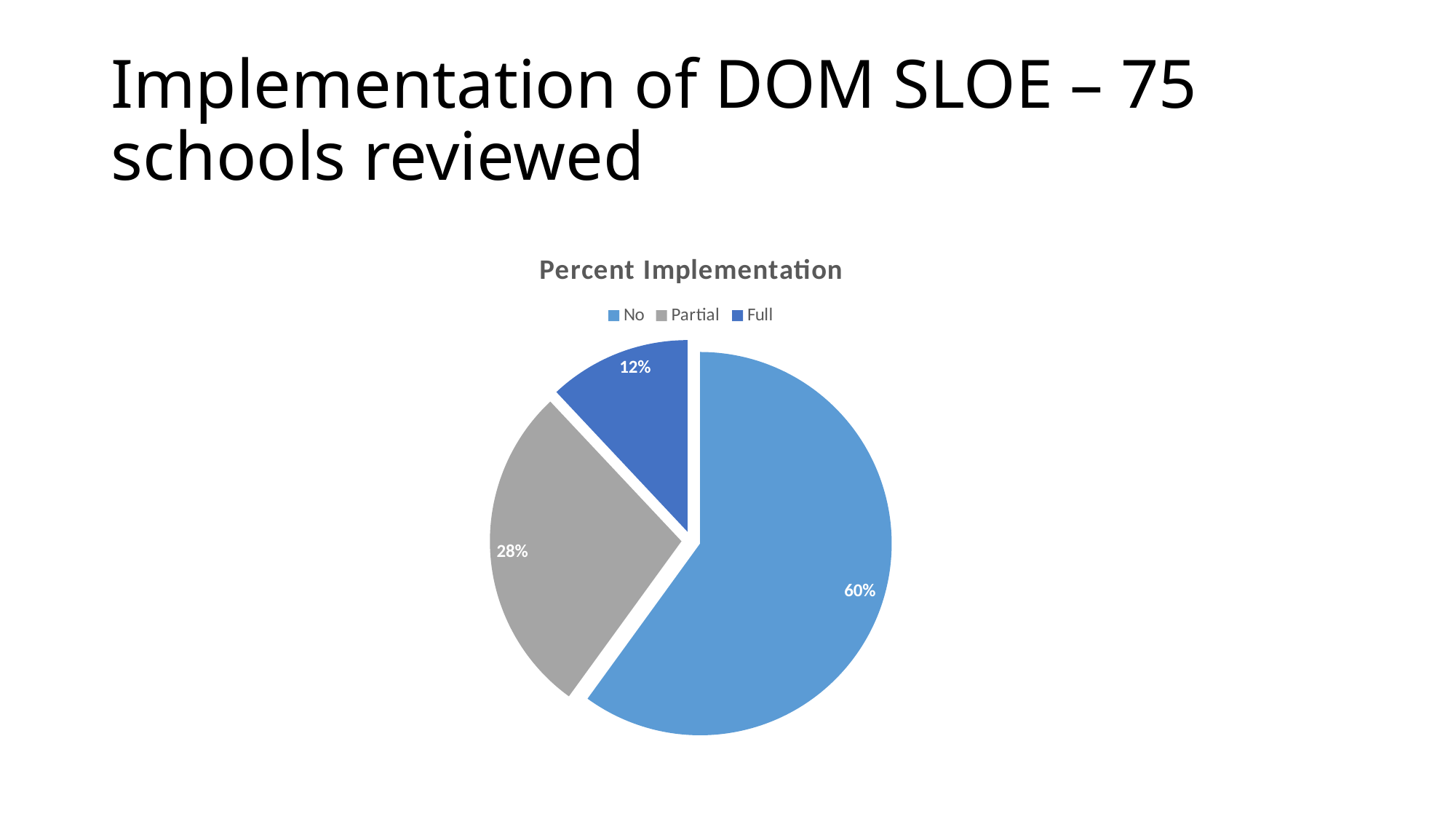
What is the difference in percentage points between the "Partial" slice and the "Full" slice? 16 Which category has the largest slice of the pie chart? No What kind of chart is shown on the slide? Pie chart What percentage of the pie chart is labelled "Full"? 12% What is the difference in percentage points between the "No" slice and the "Partial" slice? 32 How many categories are shown in the pie chart? 3 What is the title of the chart? Percent Implementation What percentage of the pie chart is labelled "Partial"? 28% Which slice is larger, "Partial" or "Full"? Partial What colour is the "Partial" slice in the pie chart? Grey Which category has the smallest slice of the pie chart? Full What percentage of the pie chart is labelled "No"? 60%